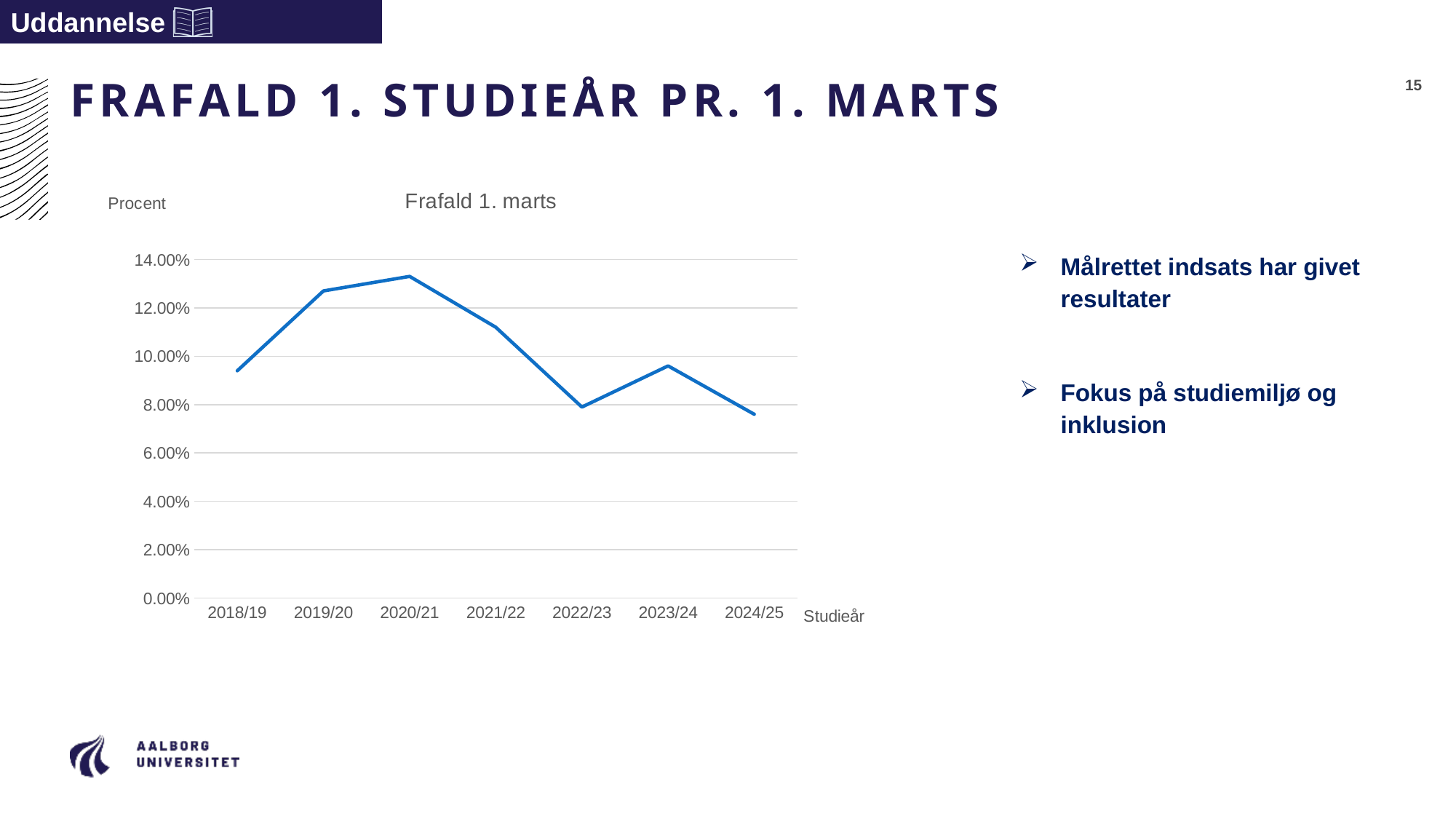
Which study year has the highest dropout rate? 2020/21 What label is shown on the x axis of the chart? Studieår Is the value for 2019/20 greater or less than 12.00%? greater What is the title of the chart? Frafald 1. marts Is the value for 2023/24 greater or less than 10.00%? less How many study years (studieår) are plotted on the x axis? 7 Is the value for 2018/19 greater or less than 10.00%? less What kind of chart is shown on the slide? line chart Which is larger, the value for 2019/20 or the value for 2018/19? 2019/20 Do the values rise or fall from 2020/21 to 2022/23? fall